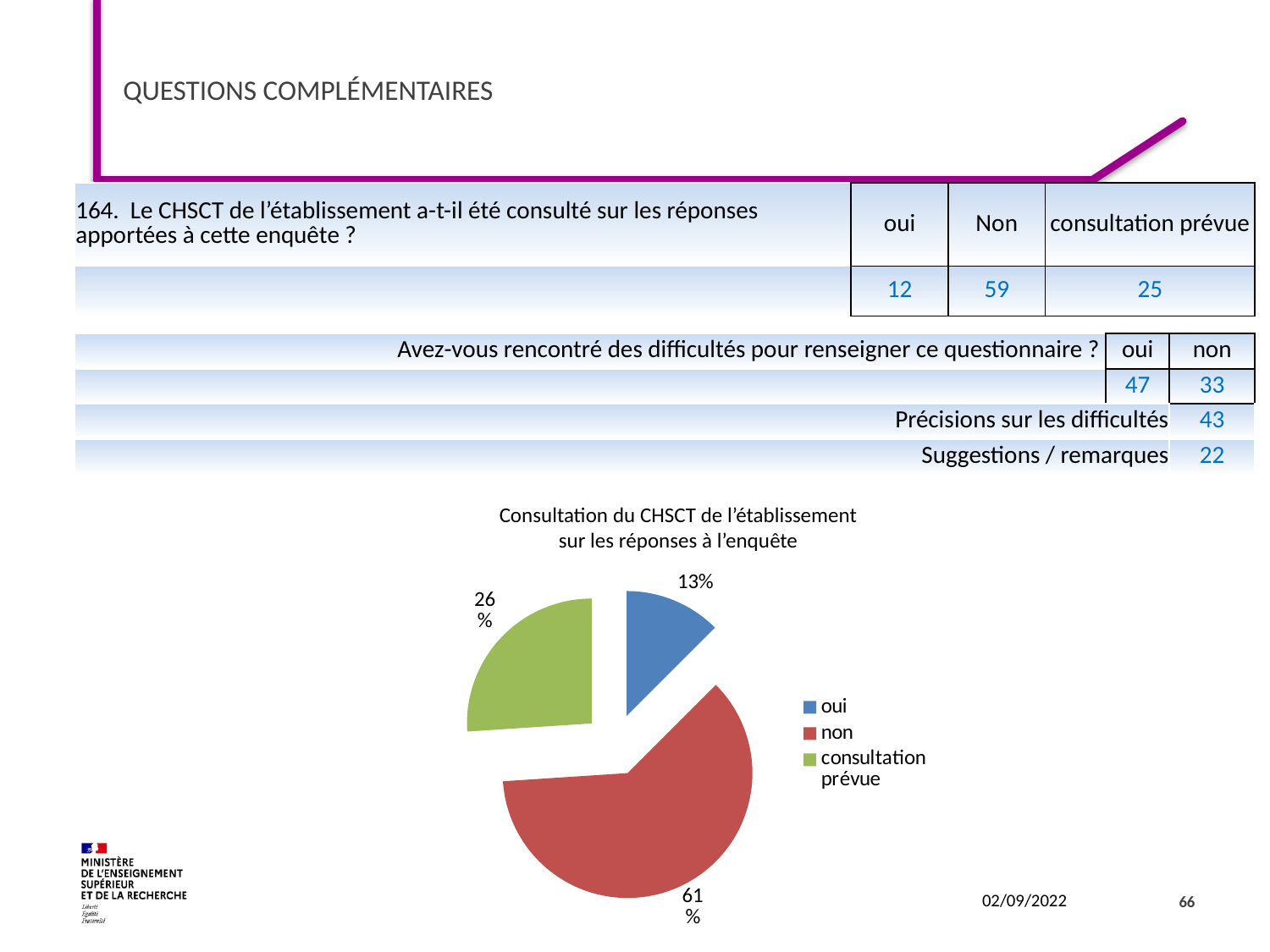
What is the title of the pie chart? Consultation du CHSCT de l'établissement sur les réponses à l'enquête Which is larger in the pie chart, the "oui" slice or the "consultation prévue" slice? consultation prévue What colour is the "non" slice in the pie chart? red What share of the pie does the "consultation prévue" slice represent? 26% Which slice of the pie chart is the smallest? oui How many entries does the legend of the pie chart list? 3 What kind of chart is shown on the slide? pie chart What share of the pie does the "oui" slice represent? 13% What is the difference in percentage points between the "non" slice and the "consultation prévue" slice? 35 Which slice of the pie chart is the largest? non How many slices does the pie chart have? 3 What share of the pie does the "non" slice represent? 61%